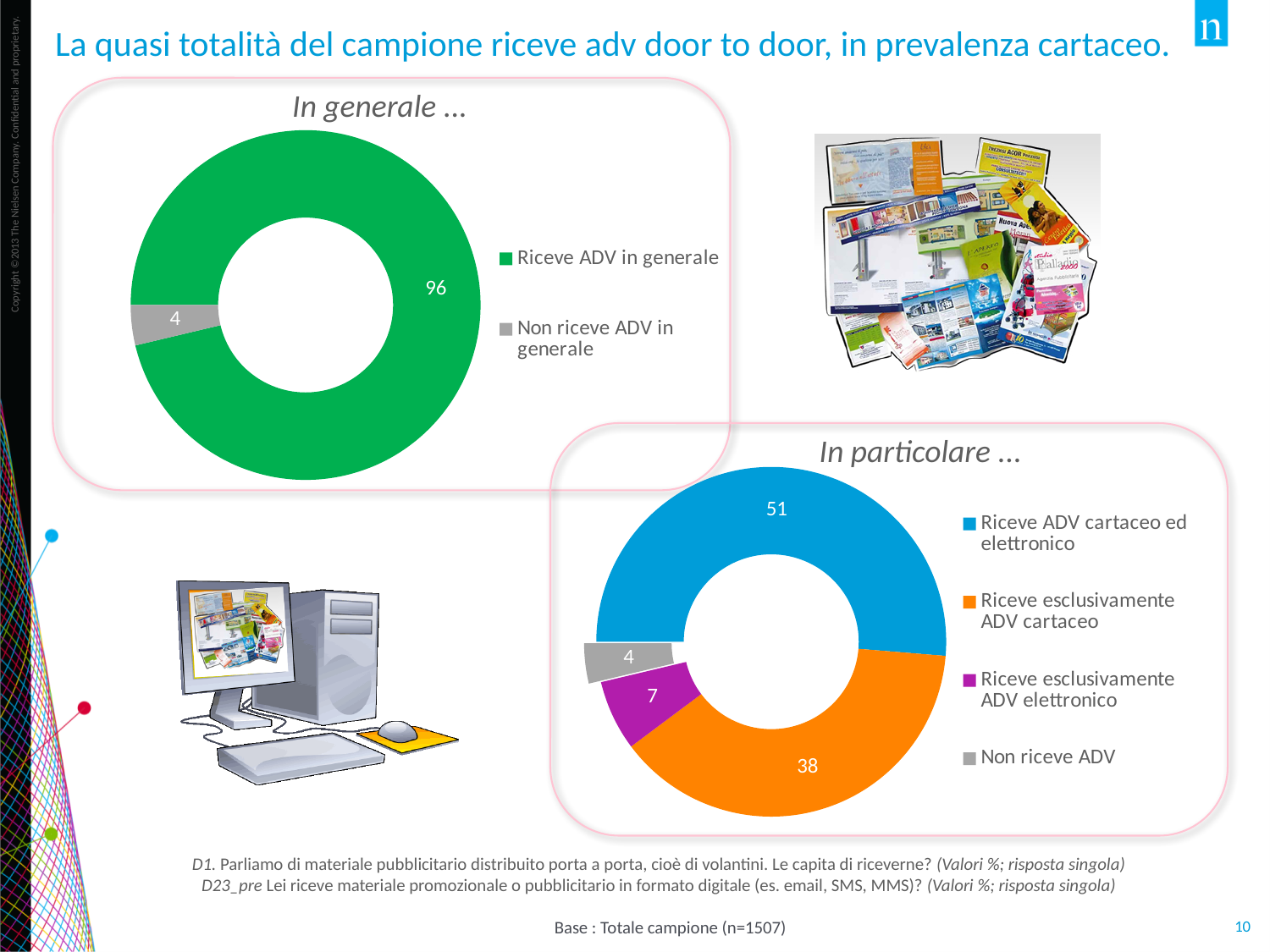
In the 'In generale ...' chart, what is the difference between 'Riceve ADV in generale' and 'Non riceve ADV in generale'? 92 In the 'In particolare ...' chart, what is the value for 'Riceve esclusivamente ADV cartaceo'? 38 In the 'In particolare ...' chart, which category has the smallest slice? Non riceve ADV In the 'In particolare ...' chart, which is larger: 'Riceve esclusivamente ADV cartaceo' or 'Riceve esclusivamente ADV elettronico'? Riceve esclusivamente ADV cartaceo In the 'In generale ...' chart, what is the value for 'Non riceve ADV in generale'? 4 In the 'In particolare ...' chart, what is the value for 'Riceve ADV cartaceo ed elettronico'? 51 In the 'In particolare ...' chart, what is the value for 'Riceve esclusivamente ADV elettronico'? 7 How many categories does the legend of the 'In particolare ...' chart list? 4 In the 'In particolare ...' chart, which category has the largest slice? Riceve ADV cartaceo ed elettronico In the 'In particolare ...' chart, what is the difference between 'Riceve ADV cartaceo ed elettronico' and 'Riceve esclusivamente ADV cartaceo'? 13 In the 'In generale ...' chart, what is the value for 'Riceve ADV in generale'? 96 What kind of chart is the 'In generale ...' chart? Pie (donut) chart